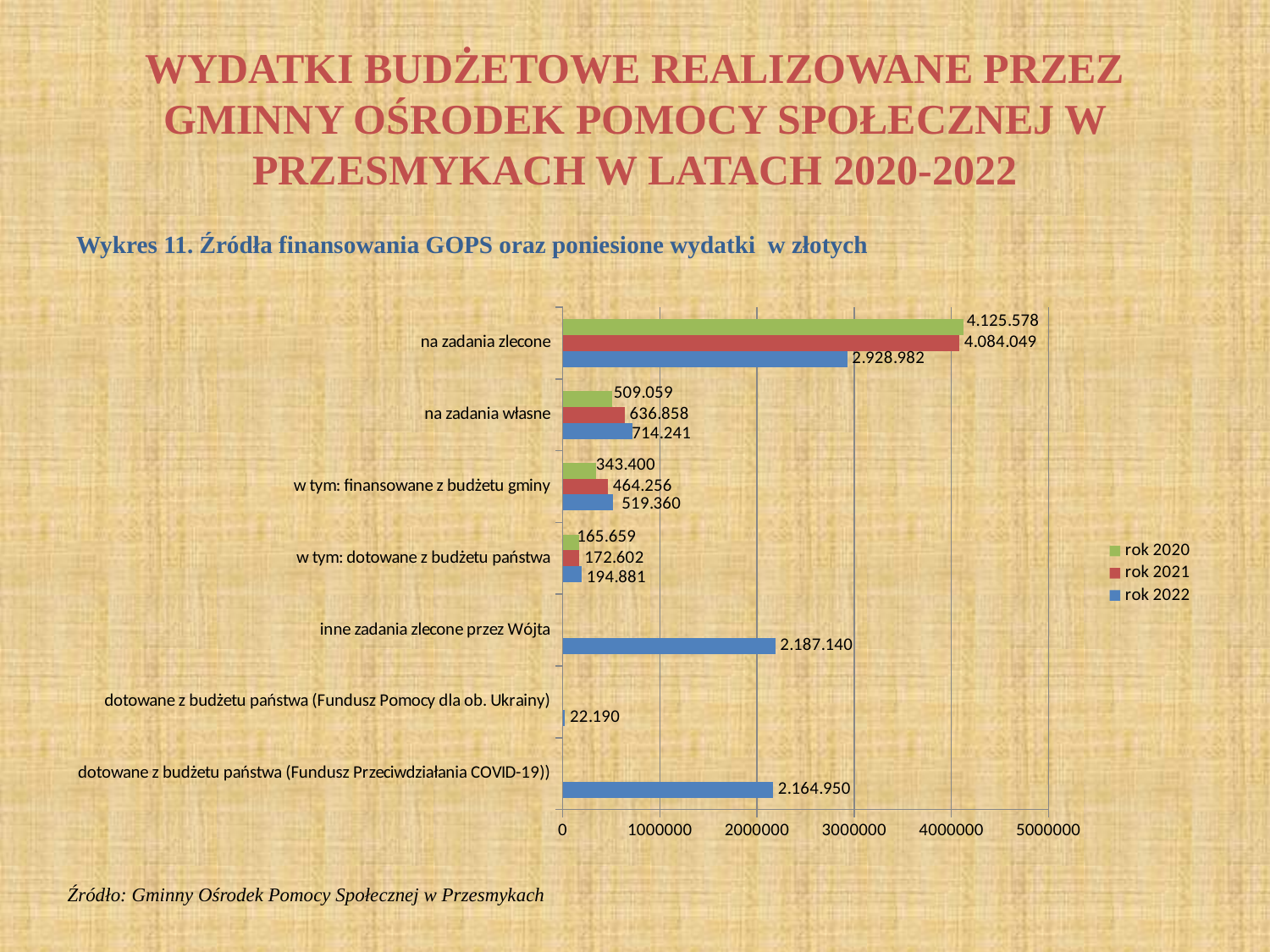
What is the value for 'na zadania zlecone' in rok 2020? 4.125.578 Which category has the highest value for rok 2021? na zadania zlecone What is the difference between the rok 2022 and rok 2020 values for 'na zadania własne'? 205.182 How many series does the legend list? 3 Which is larger for 'w tym: finansowane z budżetu gminy': the rok 2021 value or the rok 2022 value? rok 2022 Which category has the lowest value for rok 2022? dotowane z budżetu państwa (Fundusz Pomocy dla ob. Ukrainy) Is the rok 2022 value for 'na zadania zlecone' greater or less than 2000000? greater How many categories are shown on the vertical axis of the chart? 7 What is the value for 'inne zadania zlecone przez Wójta' in rok 2022? 2.187.140 What is the value for 'dotowane z budżetu państwa (Fundusz Pomocy dla ob. Ukrainy)' in rok 2022? 22.190 What type of chart is shown on the slide? bar chart What is the value for 'na zadania własne' in rok 2022? 714.241